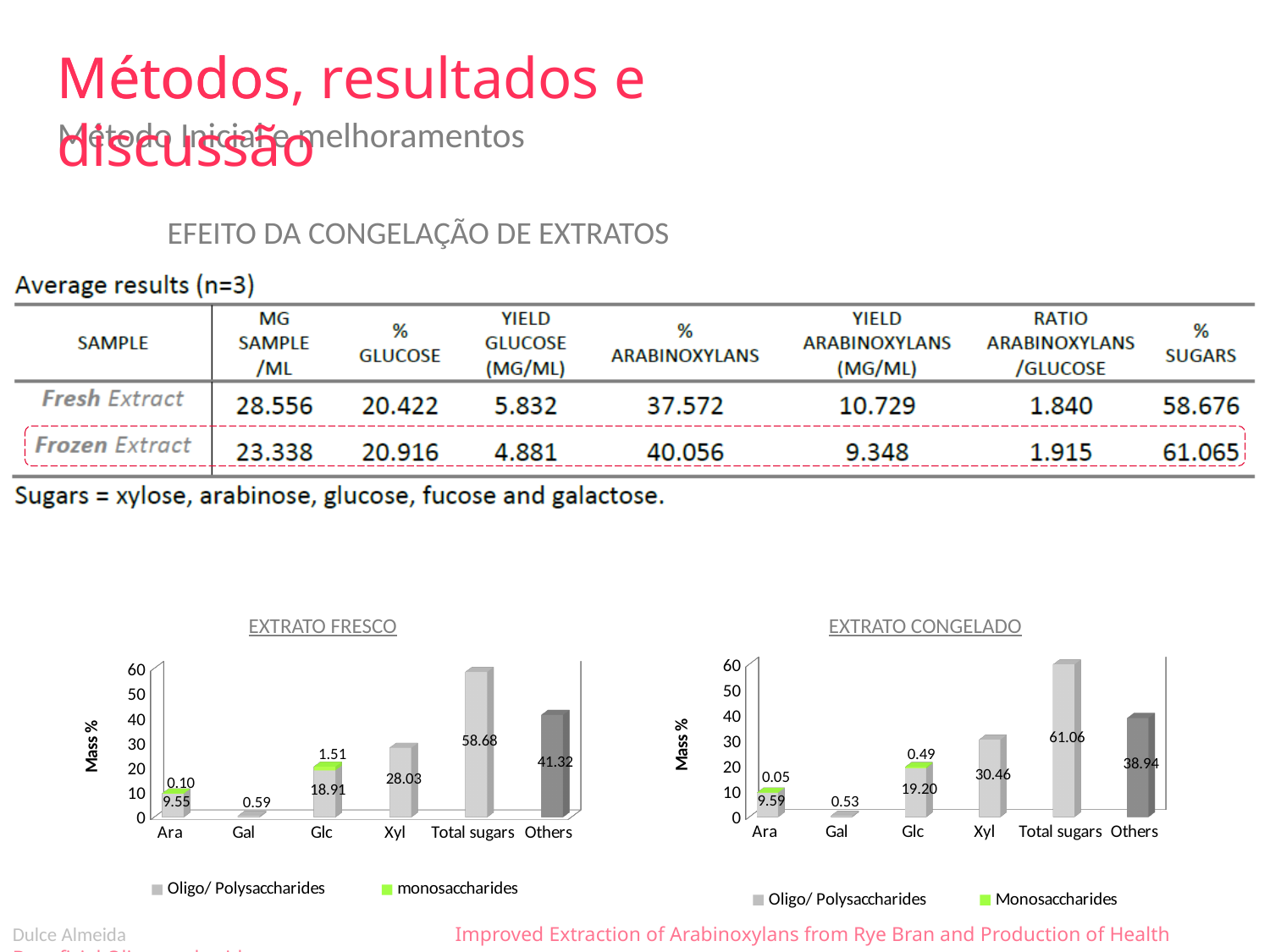
In the EXTRATO CONGELADO chart, what is the total stacked value for Glc? 19.69 In the EXTRATO CONGELADO chart, what is the Monosaccharides value for Ara? 0.05 In the EXTRATO FRESCO chart, which category has the highest Oligo/ Polysaccharides value? Total sugars In the EXTRATO FRESCO chart, what is the monosaccharides value for Glc? 1.51 In the EXTRATO FRESCO chart, what is the difference between the Oligo/ Polysaccharides values for Total sugars and Others? 17.36 How many series does the legend of the EXTRATO FRESCO chart list? 2 In the EXTRATO CONGELADO chart, which category has the lowest Oligo/ Polysaccharides value? Gal What kind of chart is the EXTRATO CONGELADO chart? Stacked bar chart How many categories are shown on the x axis of the EXTRATO CONGELADO chart? 6 In the EXTRATO FRESCO chart, what is the Oligo/ Polysaccharides value for Xyl? 28.03 In the EXTRATO CONGELADO chart, what is the Oligo/ Polysaccharides value for Total sugars? 61.06 In the EXTRATO FRESCO chart, which is larger, the Oligo/ Polysaccharides value for Xyl or for Others? Others